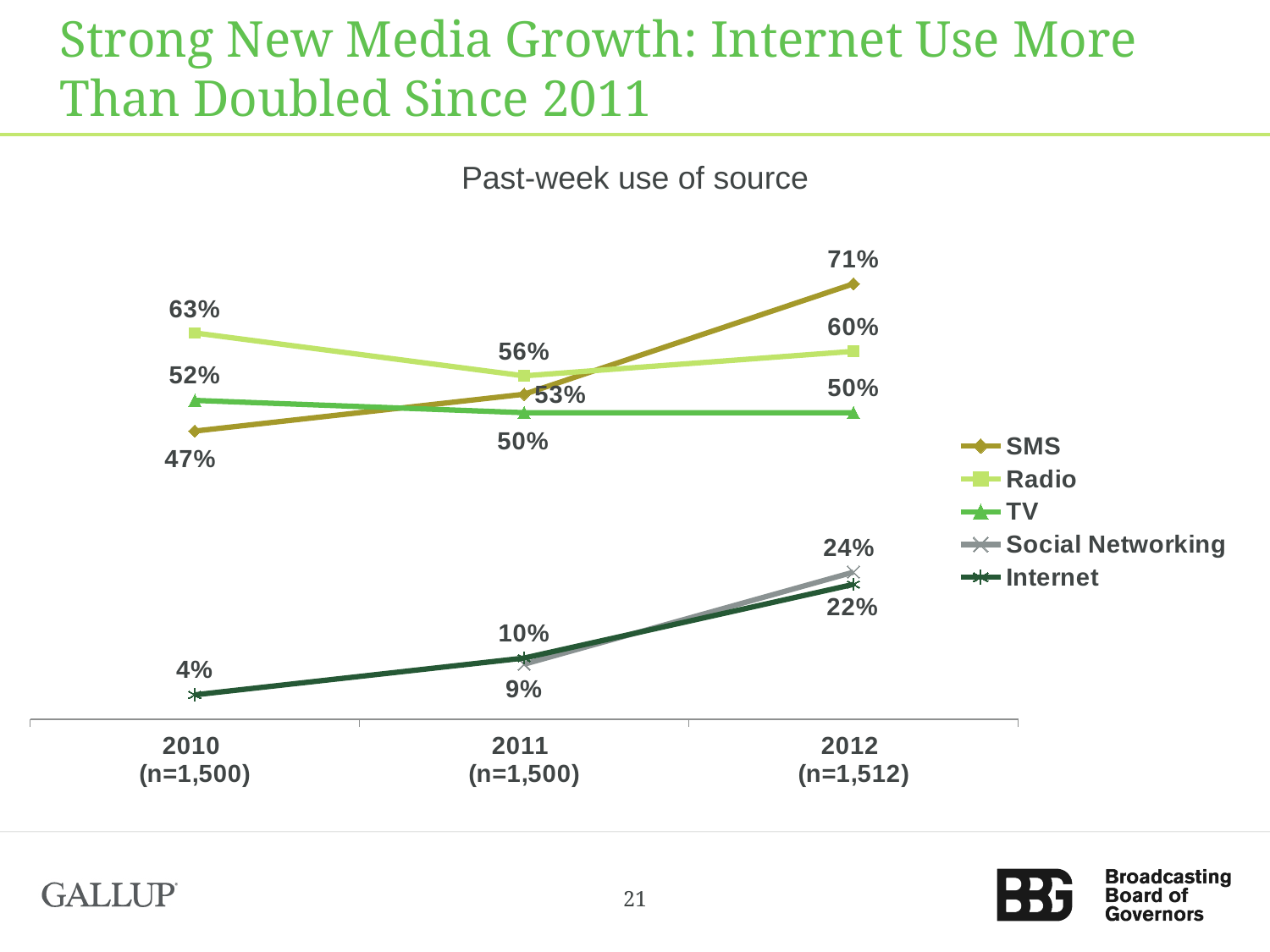
What is the value for Social Networking in 2012? 24% How many series does the legend list? 5 What is the value for Internet in 2010? 4% In 2012, which is larger: Radio or TV? Radio Which source has the lowest value in 2010? Internet What kind of chart is shown on the slide? Line chart What is the value for TV in 2012? 50% What is the value for Radio in 2010? 63% Does the SMS line rise or fall from 2010 to 2012? Rise By how many percentage points did SMS increase from 2010 to 2012? 24 percentage points What is the value for SMS in 2012? 71% Which source has the highest value in 2012? SMS